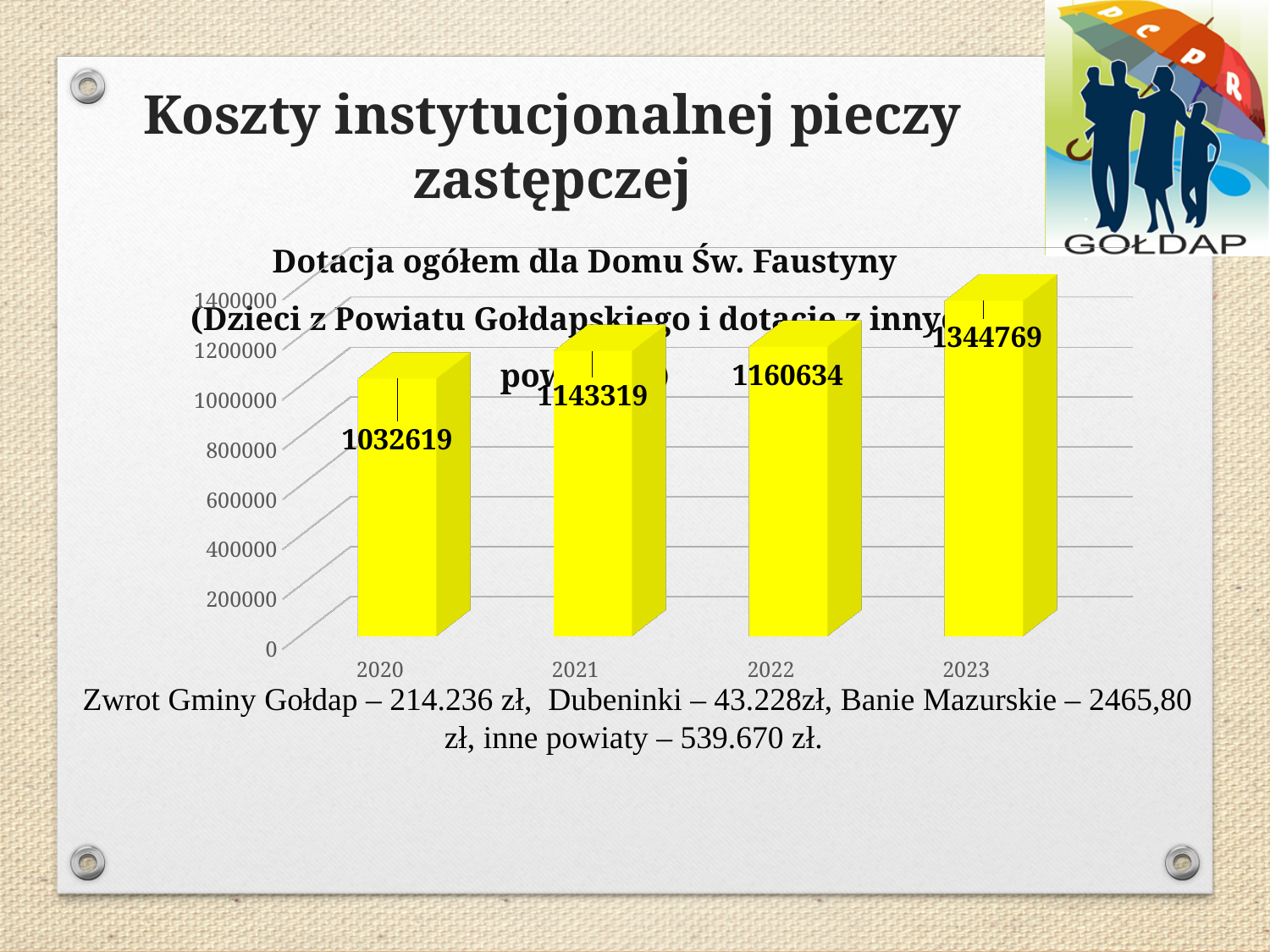
How many years are shown on the x axis? 4 What is the value for 2020? 1032619 What is the difference between the values for 2023 and 2020? 312150 Which year has the lowest value? 2020 Which is larger, the value for 2022 or the value for 2021? 2022 What is the value for 2021? 1143319 What is the value for 2022? 1160634 What is the difference between the values for 2021 and 2020? 110700 What kind of chart is shown on the slide? bar chart Is the value for 2023 greater or less than 1200000? greater Which year has the highest value? 2023 What is the value for 2023? 1344769